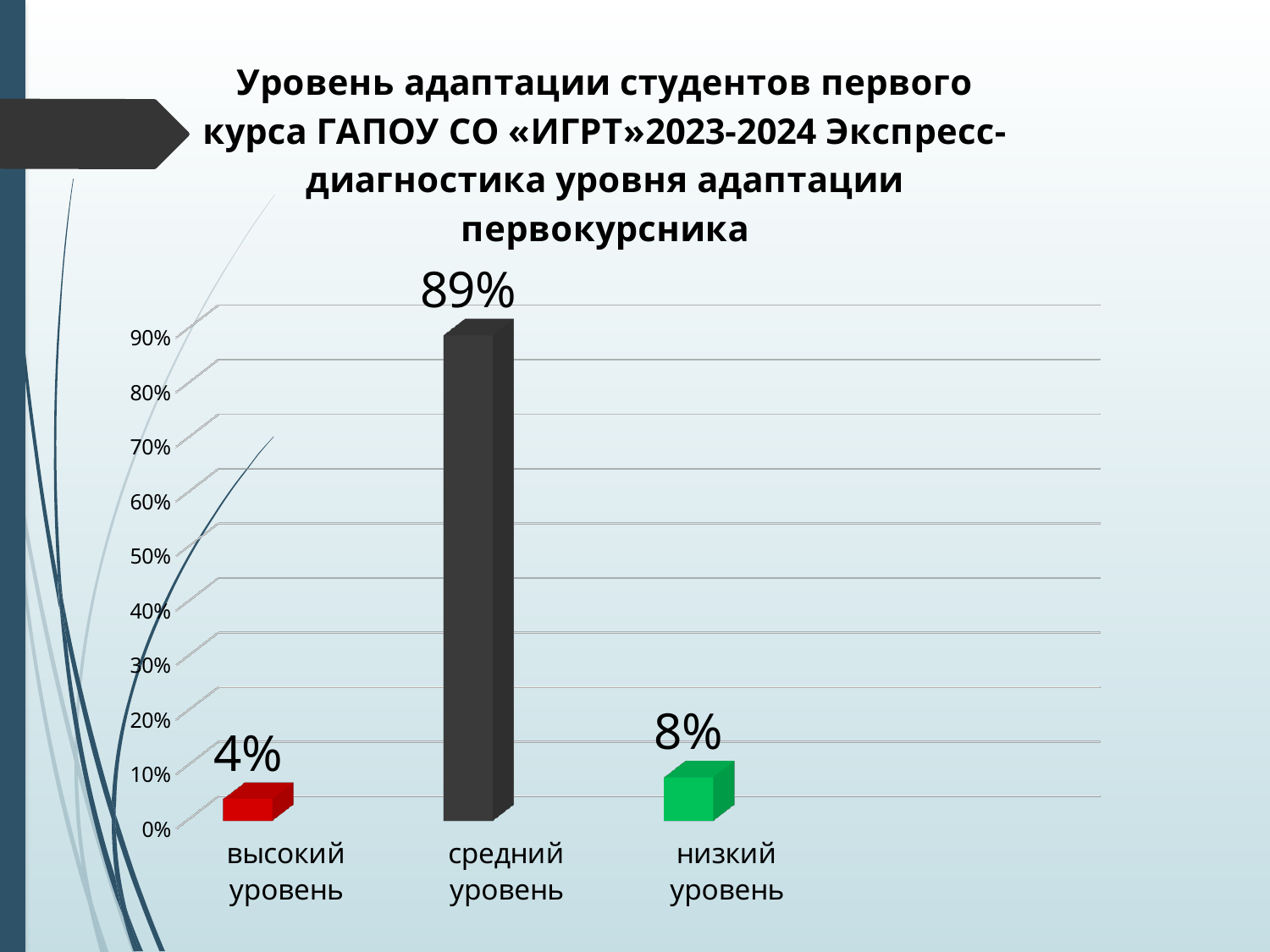
How many categories are shown on the x axis? 3 What is the difference between the values for низкий уровень and высокий уровень? 4% What is the value for низкий уровень? 8% What colour is the bar for низкий уровень? green Is the value for средний уровень greater or less than 80%? greater What is the difference between the values for средний уровень and низкий уровень? 81% What is the value for средний уровень? 89% What kind of chart is shown on the slide? bar chart Which category has the highest value? средний уровень Which category has the lowest value? высокий уровень What is the value for высокий уровень? 4% Which is larger, the value for низкий уровень or the value for высокий уровень? низкий уровень